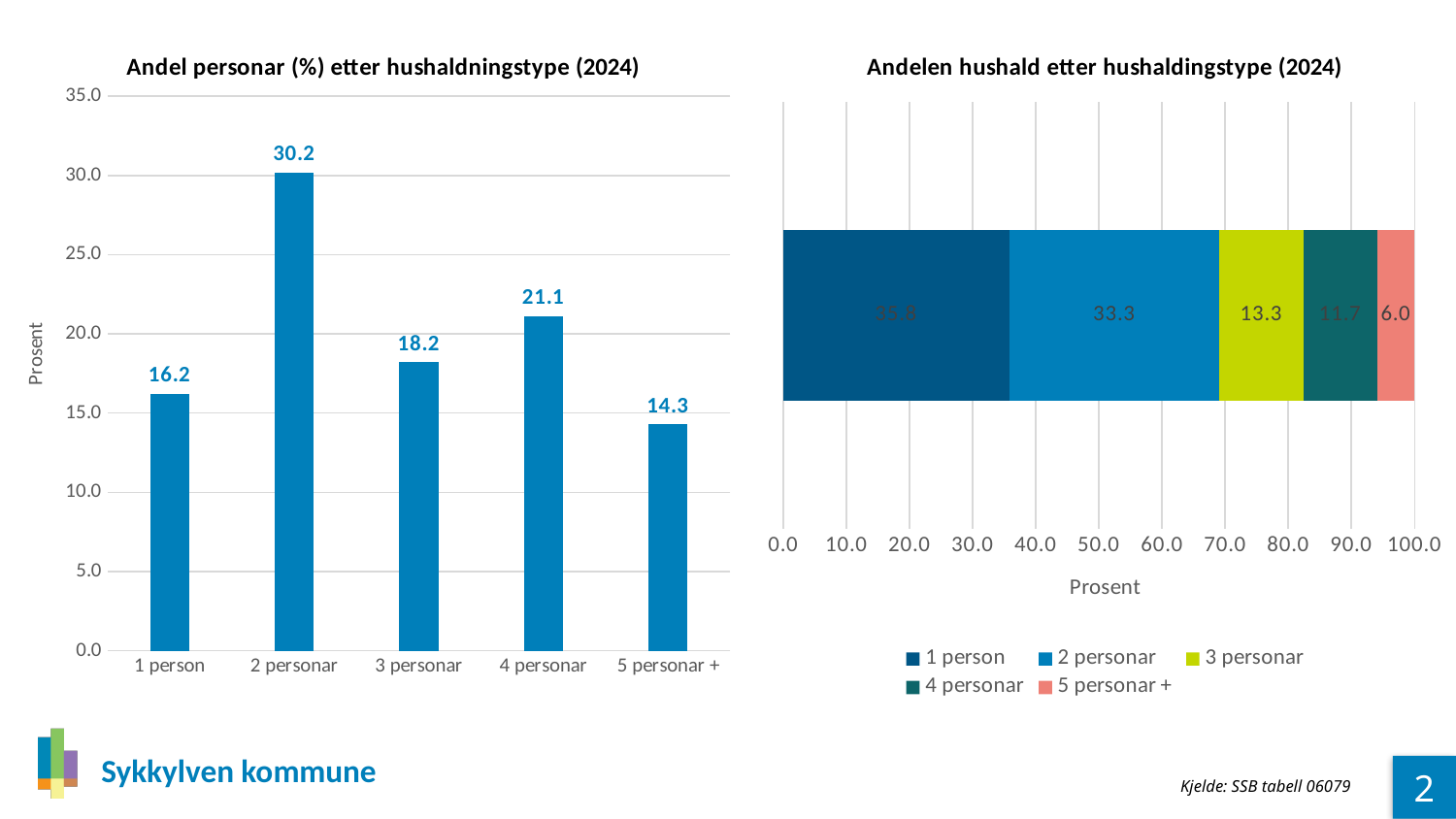
In the chart titled 'Andel personar (%) etter hushaldningstype (2024)', what is the value for 5 personar +? 14.3 In the chart titled 'Andel personar (%) etter hushaldningstype (2024)', what is the value for 2 personar? 30.2 In the chart titled 'Andel personar (%) etter hushaldningstype (2024)', what is the difference between the values for 4 personar and 3 personar? 2.9 In the chart titled 'Andelen hushald etter hushaldingstype (2024)', what is the label on the horizontal axis? Prosent In the chart titled 'Andel personar (%) etter hushaldningstype (2024)', which household type has the lowest value? 5 personar + In the chart titled 'Andel personar (%) etter hushaldningstype (2024)', how many household types are shown on the x axis? 5 In the chart titled 'Andel personar (%) etter hushaldningstype (2024)', which household type has the highest value? 2 personar In the chart titled 'Andelen hushald etter hushaldingstype (2024)', what is the value for 2 personar? 33.3 What kind of chart is the one titled 'Andel personar (%) etter hushaldningstype (2024)'? Bar chart In the chart titled 'Andelen hushald etter hushaldingstype (2024)', what is the value for 5 personar +? 6.0 In the chart titled 'Andel personar (%) etter hushaldningstype (2024)', which is larger: the value for 1 person or the value for 3 personar? 3 personar In the chart titled 'Andelen hushald etter hushaldingstype (2024)', how many series does the legend list? 5